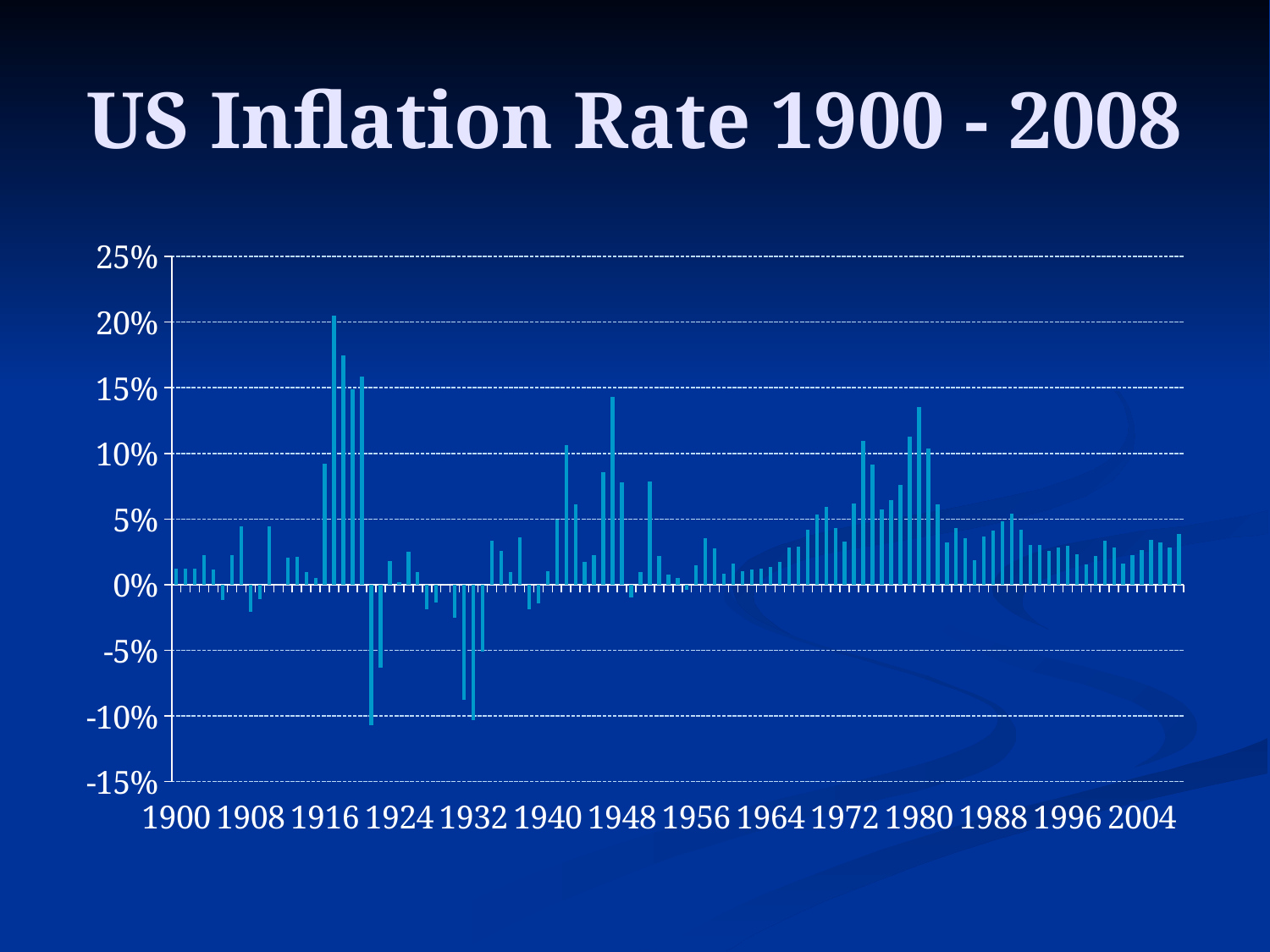
Is the value for 1948 greater or less than 5%? greater Is the value for 1980 greater or less than 10%? greater Which year has the larger value, 1980 or 2004? 1980 Is the value for 1900 greater or less than 5%? less What is the highest value shown on the vertical axis? 25% What kind of chart is shown on the slide? bar chart Between 1980 and 1988, do the values generally rise or fall? fall What is the title of the chart? US Inflation Rate 1900 - 2008